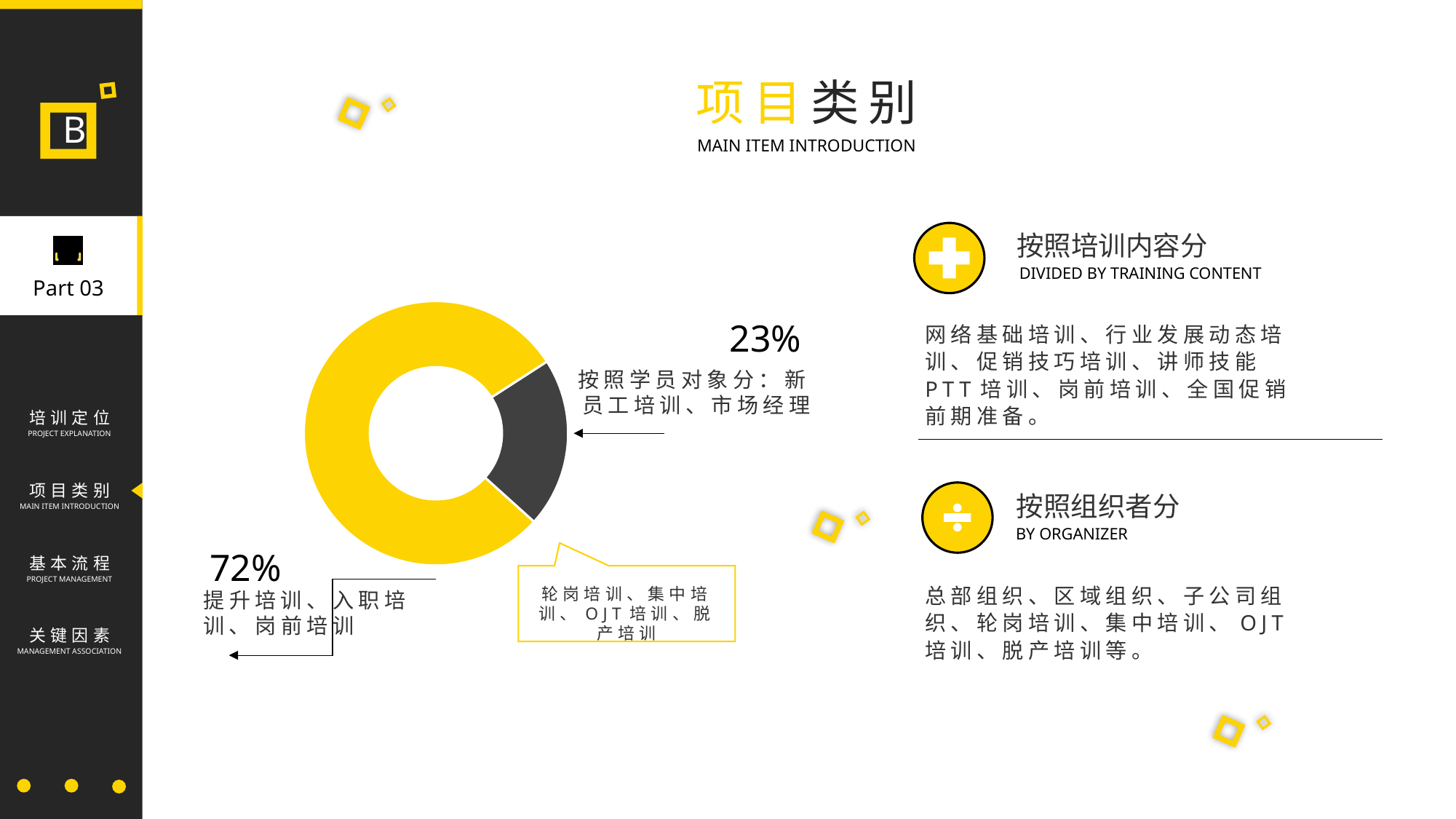
Is the yellow slice's share greater or less than 50%? greater What is the title of the slide containing the donut chart? 项目类别 (MAIN ITEM INTRODUCTION) Which is larger: the yellow slice or the dark grey slice? The yellow slice What kind of chart is shown on the slide? Donut (pie) chart Which slice of the donut chart is the largest? The yellow slice (72%) What share of the donut is labelled for the slice described as 提升培训、入职培训、岗前培训? 72% What percentage is shown for the dark grey slice of the donut chart? 23% What percentage is shown for the yellow slice of the donut chart? 72% What colour is the slice labelled 23%? Dark grey What is the difference between the 72% slice and the 23% slice? 49 percentage points Which slice of the donut chart is the smallest? The dark grey slice (23%) How many slices does the donut chart have? 2